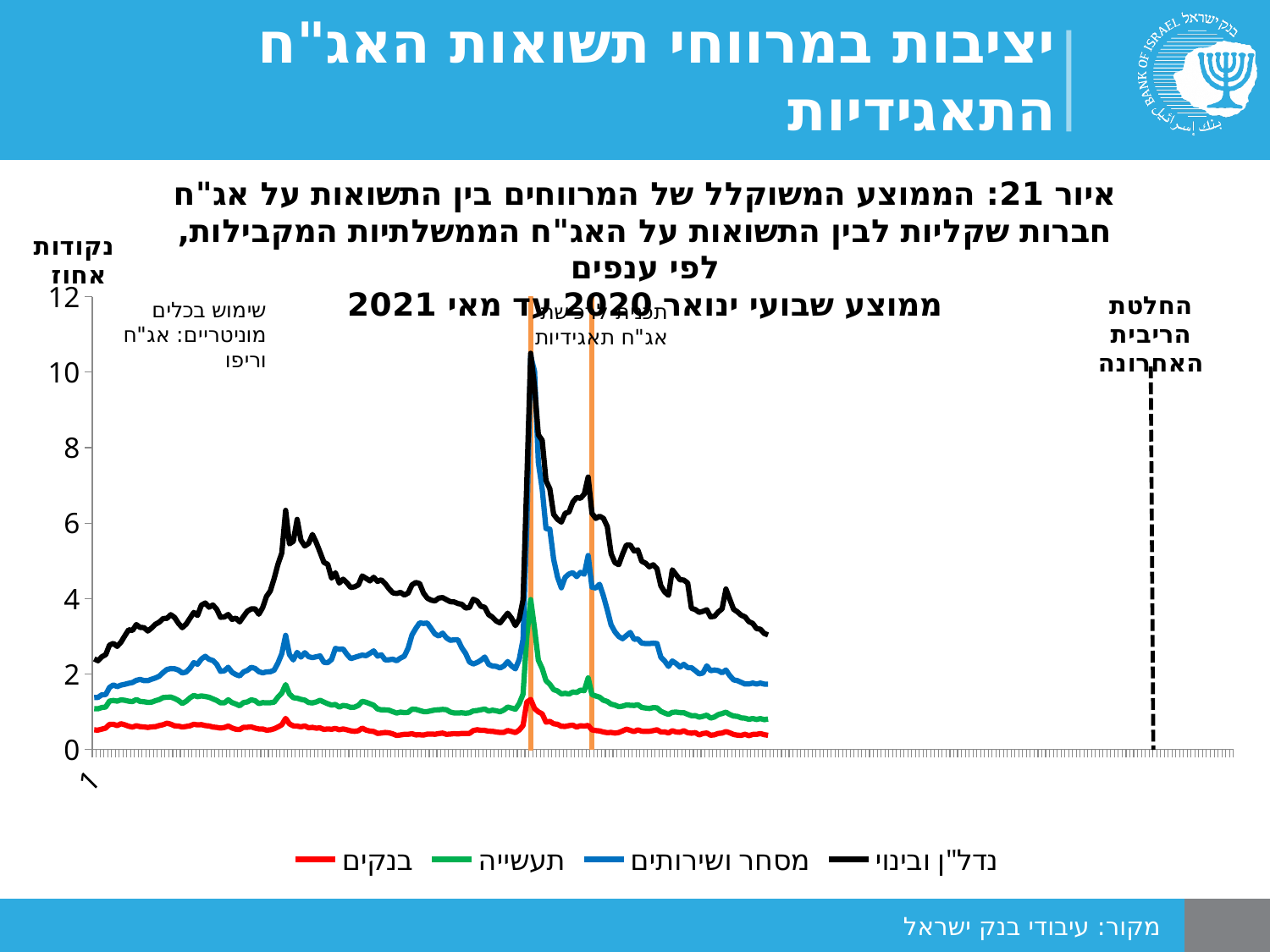
Which series has the lowest values throughout the chart? בנקים Which series has larger values, מסחר ושירותים or תעשייה? מסחר ושירותים What kind of chart is shown on the slide? line chart Is the peak value of the תעשייה series greater or less than 2? greater Is the peak value of the בנקים series greater or less than 2? less What is the highest tick value shown on the y axis? 12 Which series has the highest values throughout the chart? נדל"ן ובינוי How many series does the legend list? 4 Is the peak value of the מסחר ושירותים series greater or less than 6? greater What colour is the line for the בנקים series? red